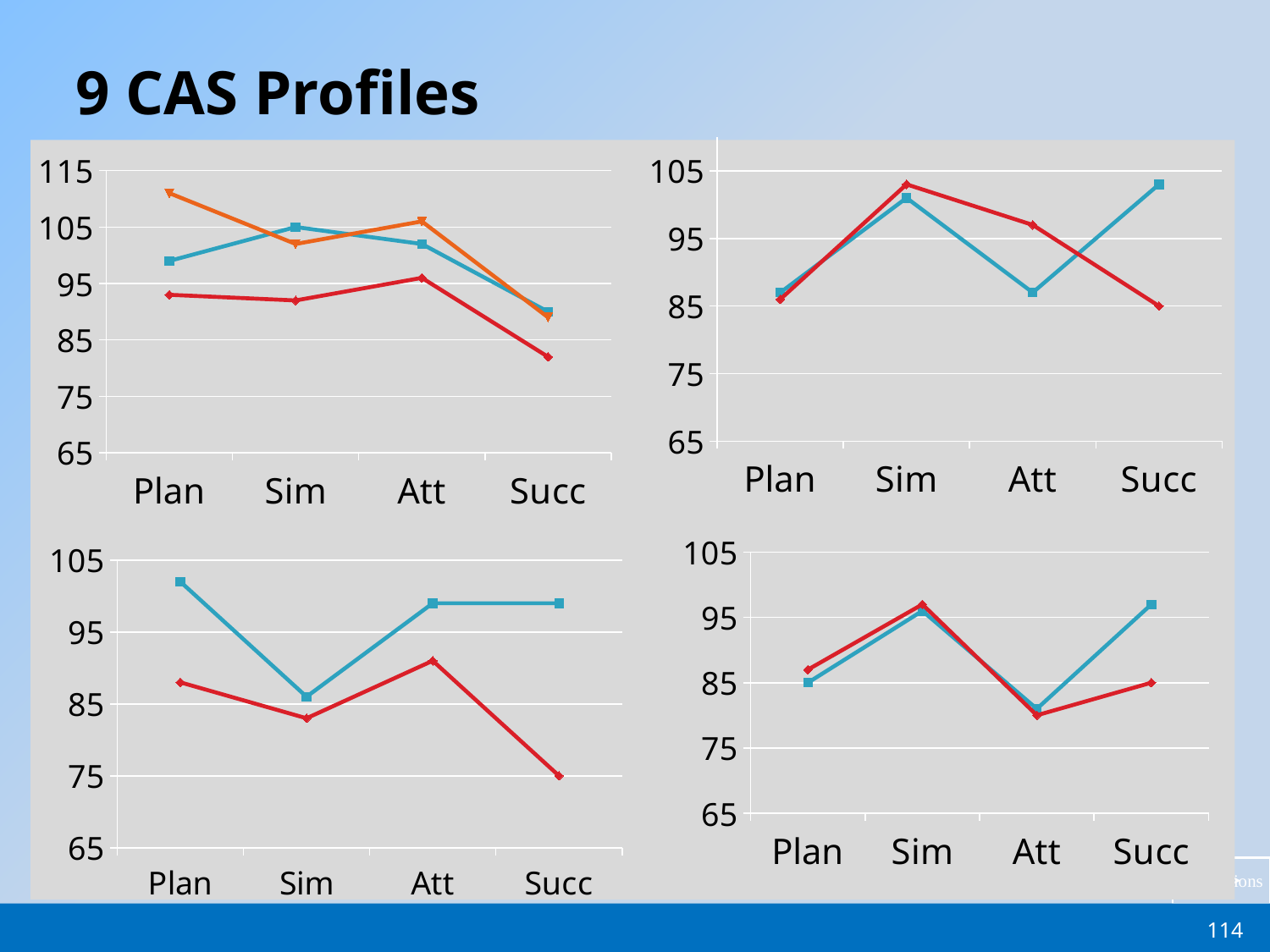
What kind of chart is the top-left chart? line chart In the bottom-right chart, is the value of the red line at Att greater or less than 85? less How many charts are shown on the slide? 4 In the top-right chart, at which category does the red line reach its highest value? Sim In the top-left chart, is the value of the orange line at Plan greater or less than 105? greater In the bottom-left chart, at which category does the red line reach its lowest value? Succ In the top-left chart, is the value of the red line at Succ greater or less than 85? less In the bottom-left chart, at Succ, which line has the larger value, the blue line or the red line? blue line How many lines are plotted in the top-left chart? 3 In the bottom-right chart, at which category does the blue line reach its lowest value? Att How many categories are shown on the x axis of the top-left chart? 4